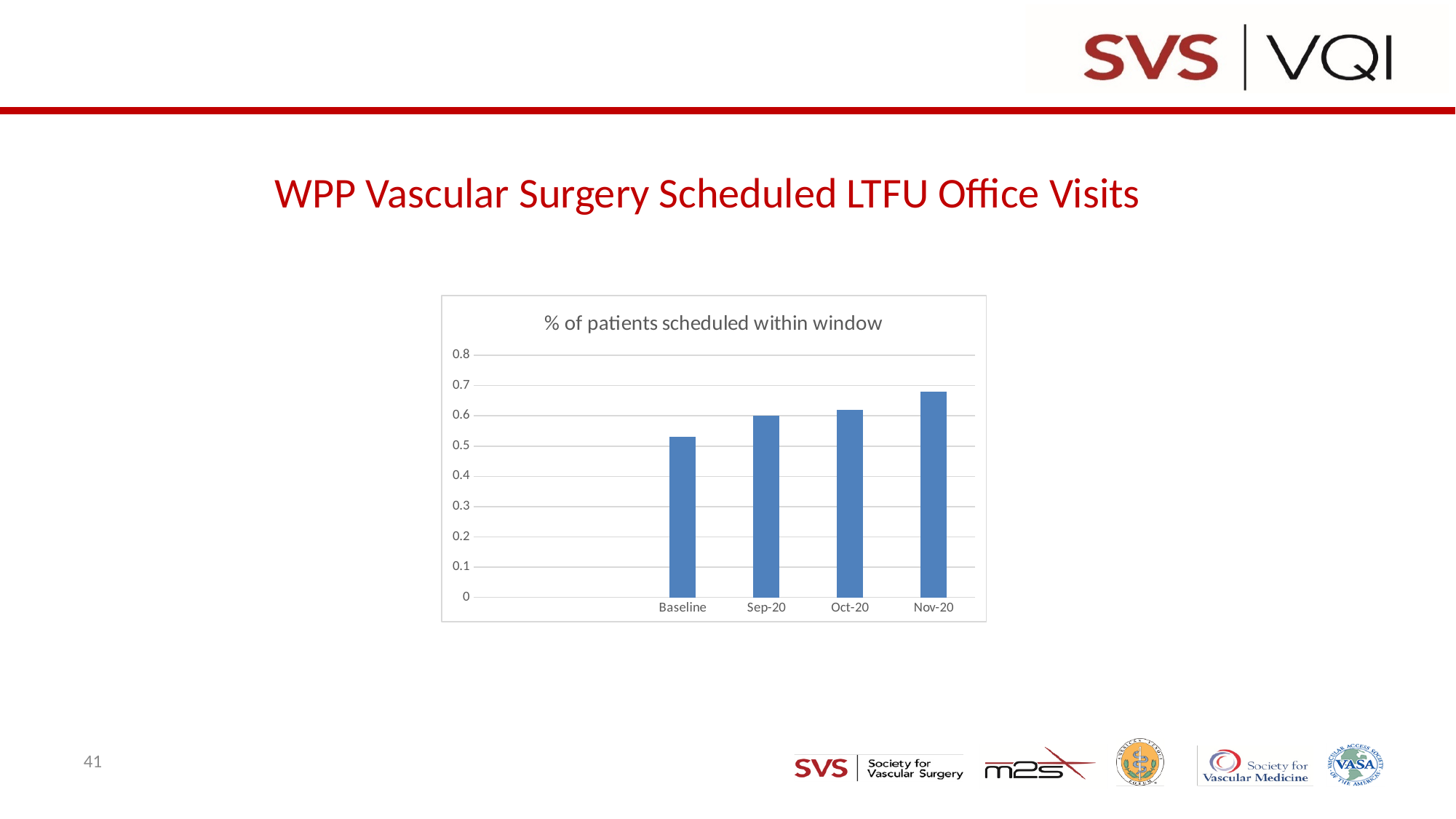
Is the value for Baseline greater or less than 0.6? less Do the values rise or fall from Baseline to Nov-20? rise Which category has the lowest value in the chart? Baseline What is the title of the chart? % of patients scheduled within window Which is larger, the value for Nov-20 or the value for Baseline? Nov-20 Which is larger, the value for Sep-20 or the value for Nov-20? Nov-20 Is the value for Nov-20 greater or less than 0.7? less How many categories are shown on the x axis of the chart? 4 What kind of chart is shown on the slide? bar chart Which category has the highest value in the chart? Nov-20 Is the value for Baseline greater or less than 0.5? greater